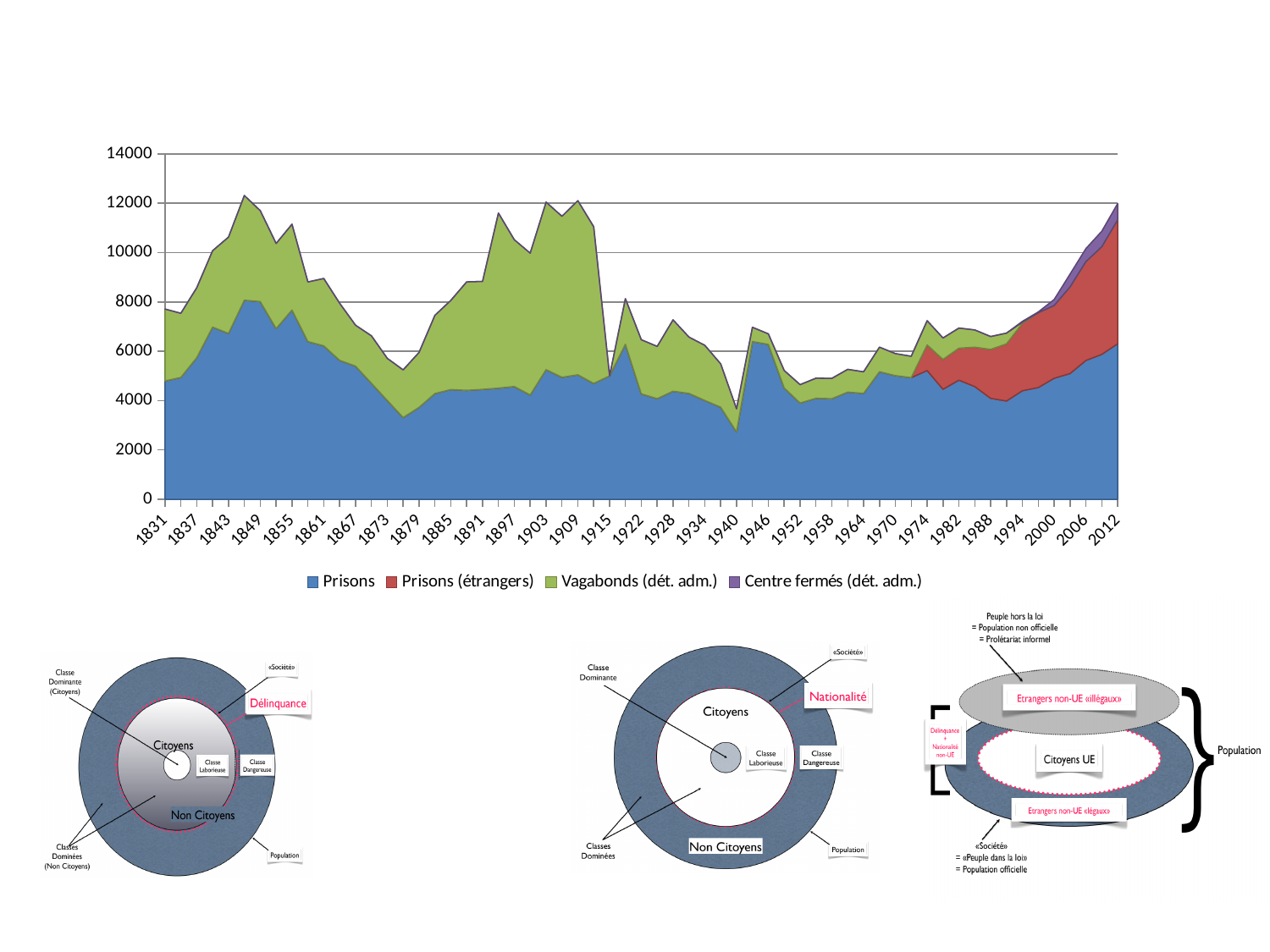
What is the first year label and the last year label on the x axis of the chart? 1831 and 2012 Between 1994 and 2012, does the total stacked value rise or fall? rises Which series is plotted as the bottom (blue) layer of the stacked area chart? Prisons Is the total stacked value in 1940 greater or less than 6000? less Is the total stacked value in 1849 greater or less than 10000? greater Is the total stacked value in 2012 greater or less than 10000? greater How many series does the legend of the top chart list? 4 What kind of chart is shown at the top of the slide? Stacked area chart Between 1831 and 1849, does the value for Prisons rise or fall? rises Which colour represents the series Vagabonds (dét. adm.) in the chart? Green